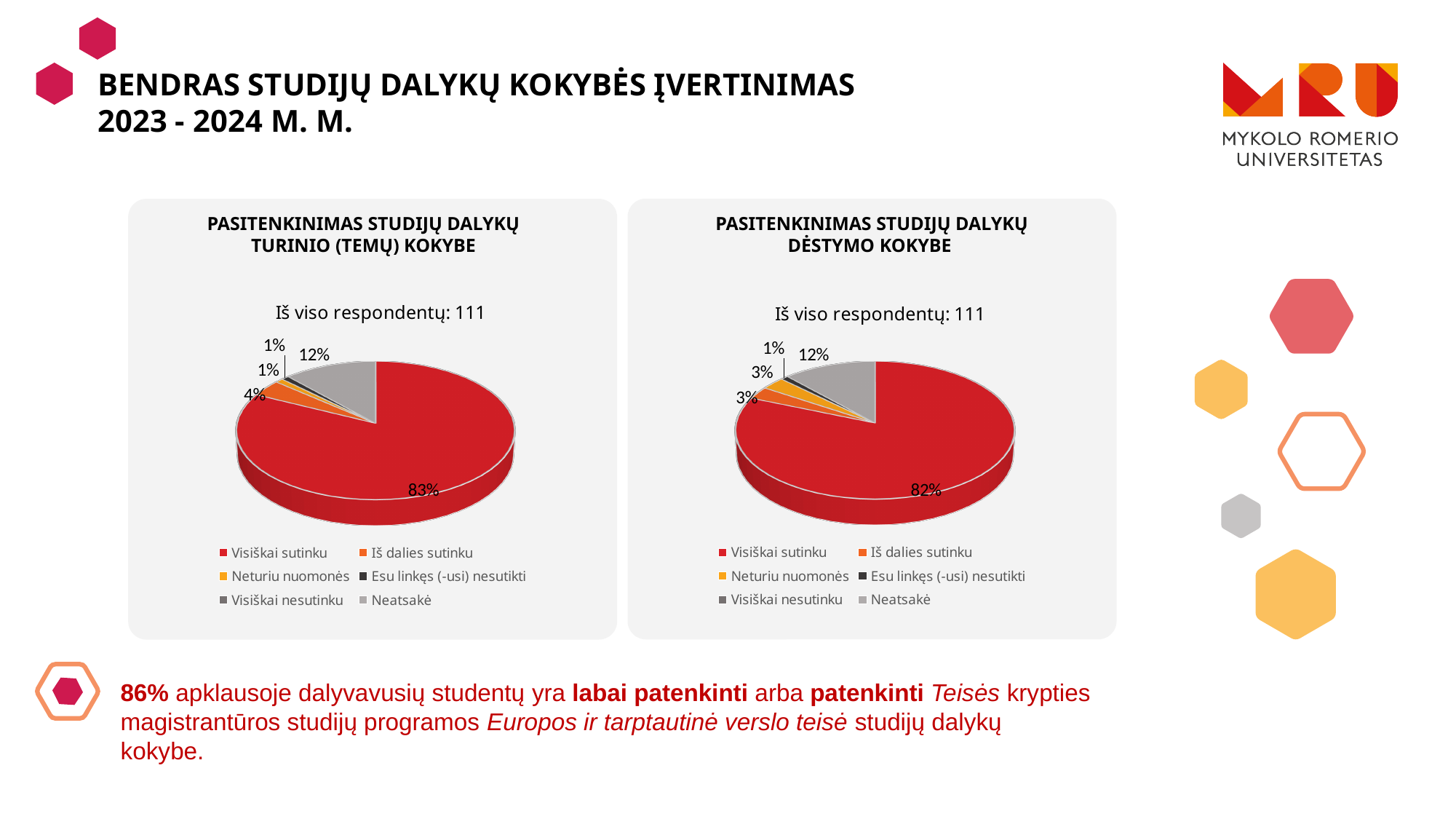
On the right chart (Dėstymo kokybe), what share is labelled for the "Neatsakė" slice? 12% On the left chart (Turinio (temų) kokybe), what share is labelled for the "Neatsakė" slice? 12% What type of chart is used on this slide? Pie chart How many respondents in total are reported for the right chart (Dėstymo kokybe)? 111 How many entries does the legend of the left chart list? 6 On the left chart (Turinio (temų) kokybe), which category has the largest slice? Visiškai sutinku On the left chart (Turinio (temų) kokybe), what share of respondents chose "Visiškai sutinku"? 83% On the left chart (Turinio (temų) kokybe), what share of respondents chose "Iš dalies sutinku"? 4% What is the difference between the "Visiškai sutinku" share on the left chart and on the right chart? 1 percentage point Which chart has the larger "Visiškai sutinku" share, the left (Turinio (temų) kokybe) or the right (Dėstymo kokybe)? Left (Turinio (temų) kokybe) On the right chart (Dėstymo kokybe), what share of respondents chose "Visiškai sutinku"? 82% On the right chart (Dėstymo kokybe), which category has the largest slice? Visiškai sutinku